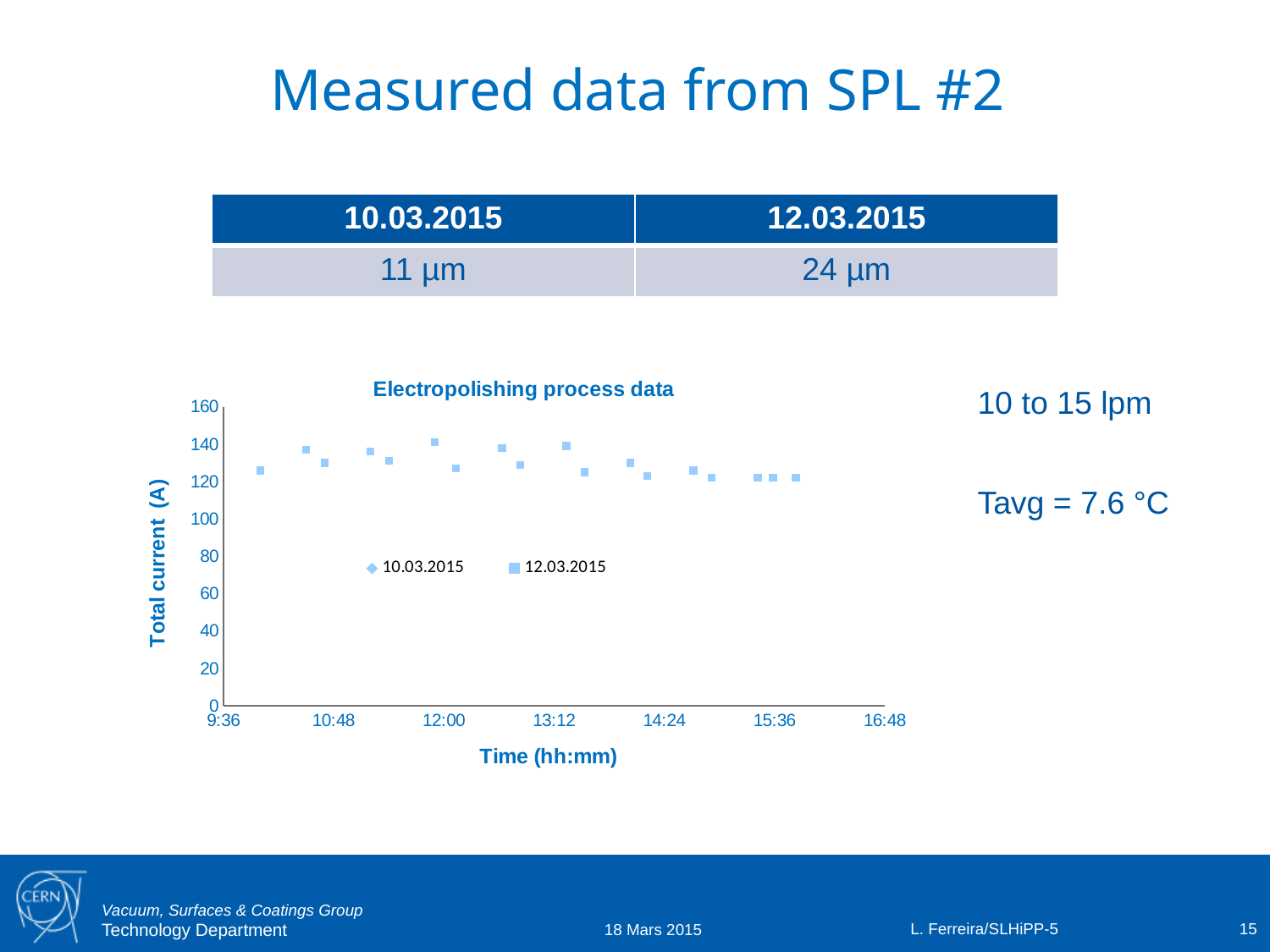
Is the highest plotted point in the chart greater or less than 160? less Is the value of the first plotted point (around 10:00) greater or less than 100? greater Are all plotted points in the chart greater or less than 80 A? greater What is the title of the chart on the slide? Electropolishing process data What is the label of the vertical axis of the chart? Total current (A) Do the plotted total current values generally rise or fall from left to right along the time axis? fall What kind of chart is shown under the title 'Electropolishing process data'? scatter chart How many series does the legend of the 'Electropolishing process data' chart list? 2